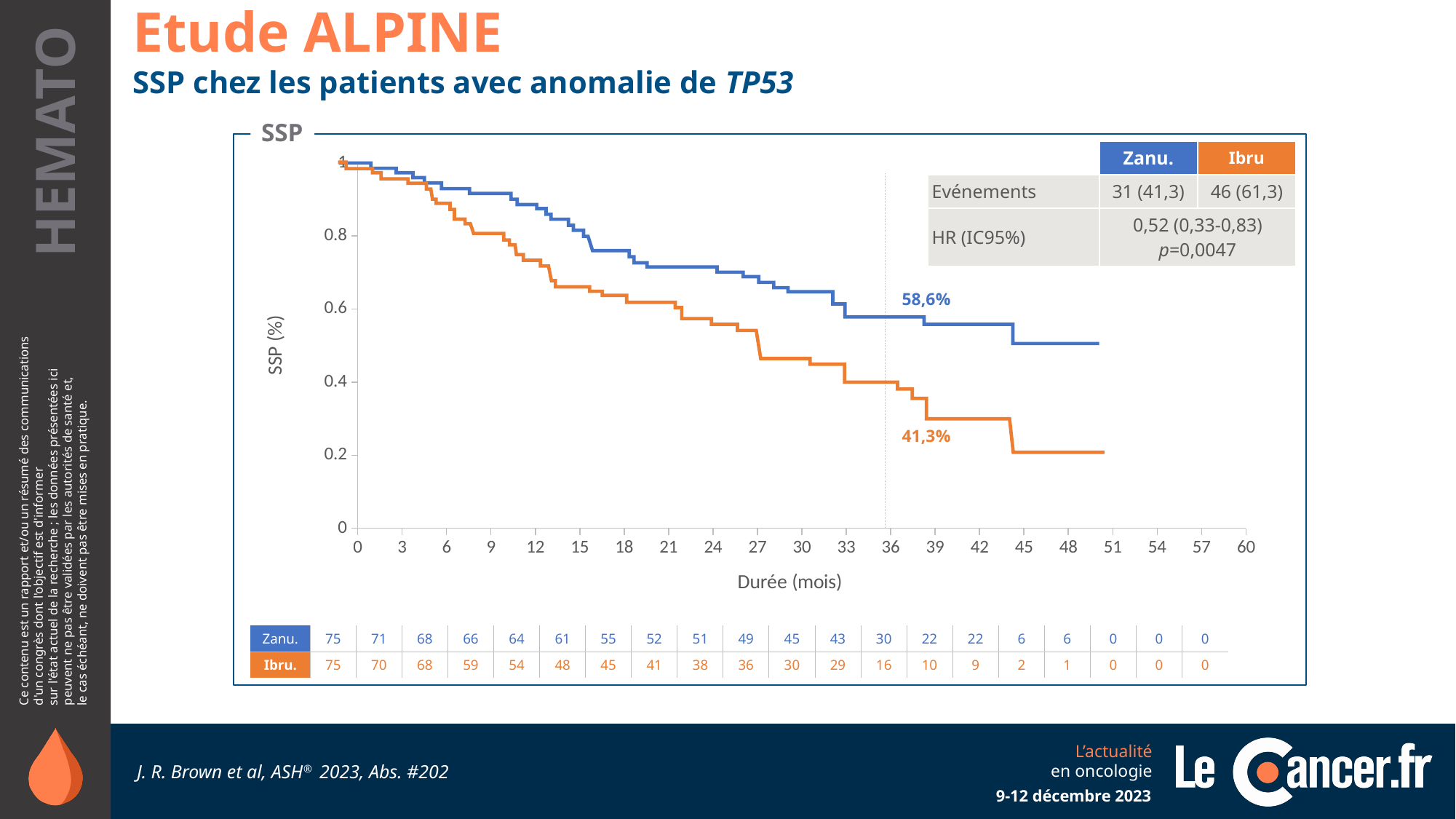
According to the number-at-risk table, how many Ibru patients were at risk at 12 months? 54 Is the value of the Zanu. curve at 48 months greater or less than 0.4? greater What is the SSP value labelled on the Zanu. curve at 36 months? 58,6% Do the SSP curves rise or fall as duration increases? fall Which curve is higher at 36 months, Zanu. or Ibru? Zanu. How many series are plotted on the SSP chart? 2 What is the SSP value labelled on the Ibru curve at 36 months? 41,3% What is the HR (IC95%) shown in the table on the chart? 0,52 (0,33-0,83) What is the difference between the labelled SSP values of Zanu. and Ibru at 36 months? 17,3 points Is the value of the Ibru curve at 48 months greater or less than 0.4? less What is the label of the x axis of the chart? Durée (mois) What kind of chart is shown on the slide? line chart